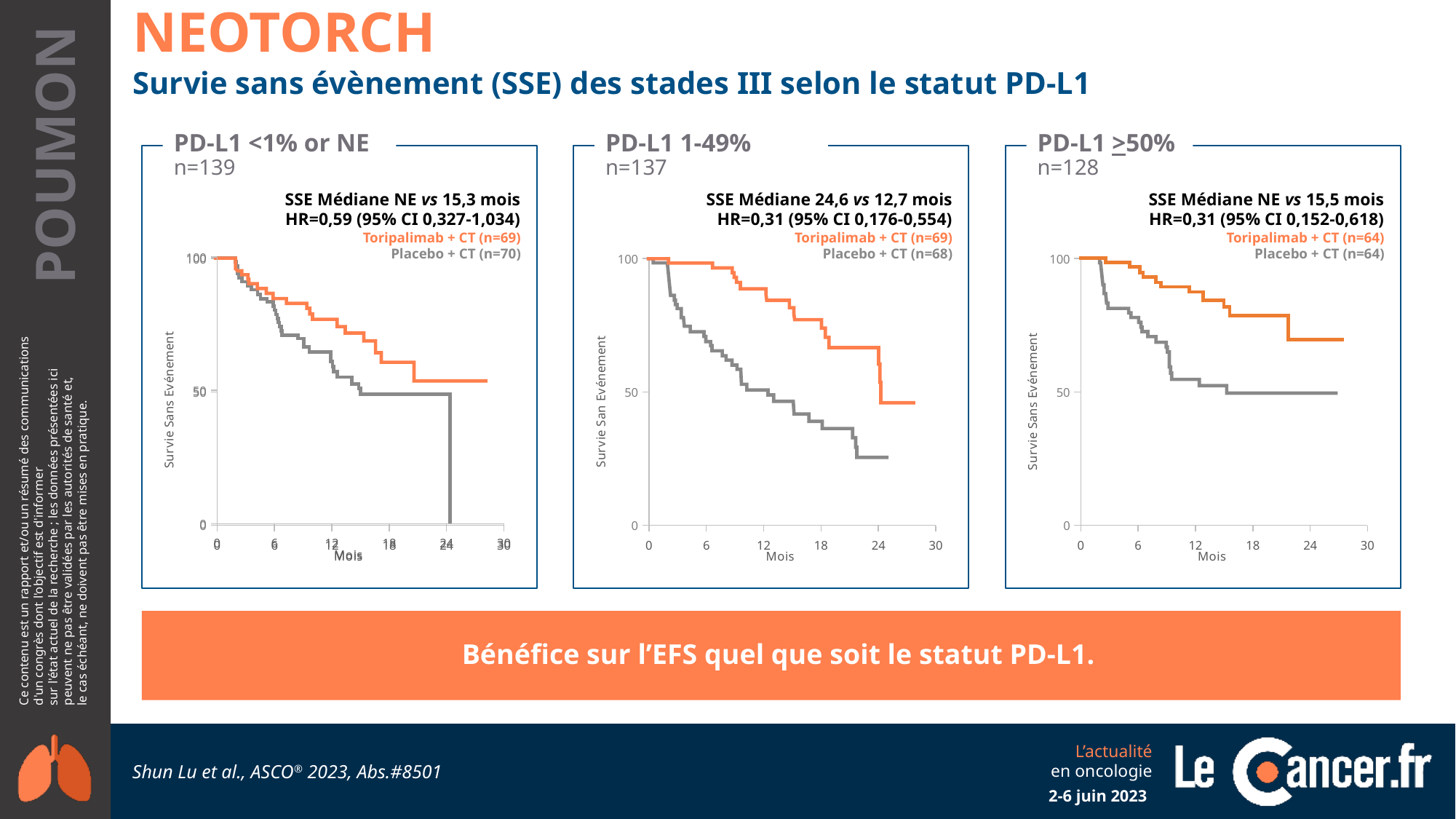
In the 'PD-L1 >50%' chart, is the Toripalimab + CT curve at 24 months greater or less than 50? greater In the 'PD-L1 <1% or NE' chart, do the curves rise or fall as months increase? fall How many charts are shown on the slide? 3 What colour is the Toripalimab + CT curve in the charts? orange How many series does the legend of the 'PD-L1 <1% or NE' chart list? 2 In the 'PD-L1 <1% or NE' chart, what is the median SSE for the Placebo + CT arm? 15,3 mois In the 'PD-L1 1-49%' chart, what is the hazard ratio (HR) reported? 0,31 What kind of chart is shown in the 'PD-L1 1-49%' panel? line chart In the 'PD-L1 >50%' chart, how many patients are in the Toripalimab + CT arm? 64 In the 'PD-L1 1-49%' chart, which curve is higher at 12 months, Toripalimab + CT or Placebo + CT? Toripalimab + CT In the 'PD-L1 >50%' chart, what is the 95% CI of the hazard ratio? 0,152-0,618 In the 'PD-L1 1-49%' chart, is the Placebo + CT curve at 24 months greater or less than 50? less